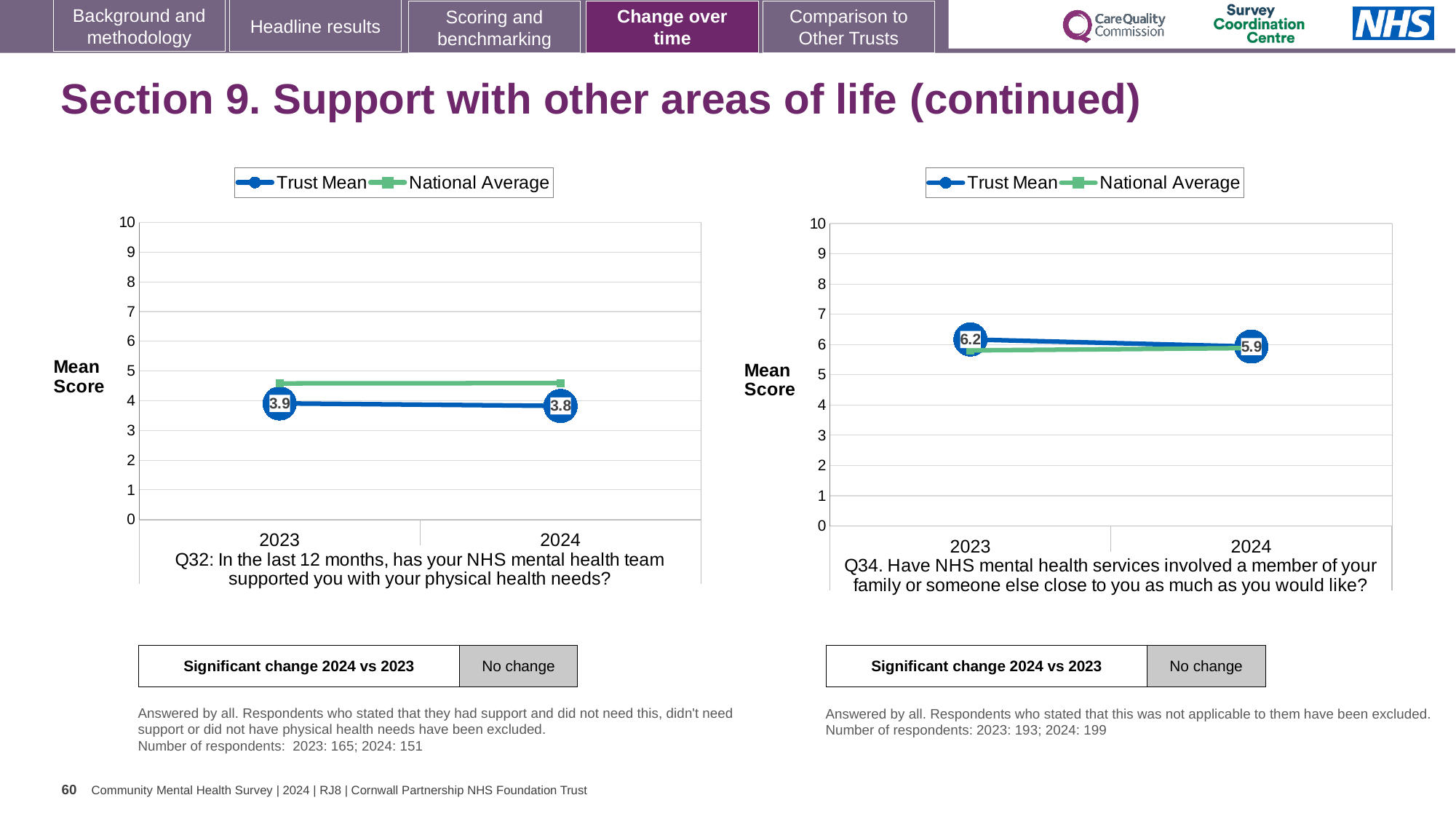
In the Q32 chart on the left, which series is higher in 2024, Trust Mean or National Average? National Average In the Q34 chart on the right, what is the Trust Mean score for 2023? 6.2 In the Q32 chart on the left, does the Trust Mean rise or fall from 2023 to 2024? fall How many series does the legend of the Q34 chart on the right list? 2 In the Q32 chart on the left, is the National Average value for 2023 greater or less than 4? greater In the Q32 chart on the left, what is the Trust Mean score for 2023? 3.9 How many years are plotted on the x axis of the Q32 chart on the left? 2 In the Q34 chart on the right, is the National Average value for 2023 greater or less than 5? greater In the Q32 chart on the left, what is the Trust Mean score for 2024? 3.8 What type of chart is the Q34 chart on the right? line chart In the Q34 chart on the right, what is the Trust Mean score for 2024? 5.9 In the Q34 chart on the right, by how much did the Trust Mean change from 2023 to 2024? 0.3